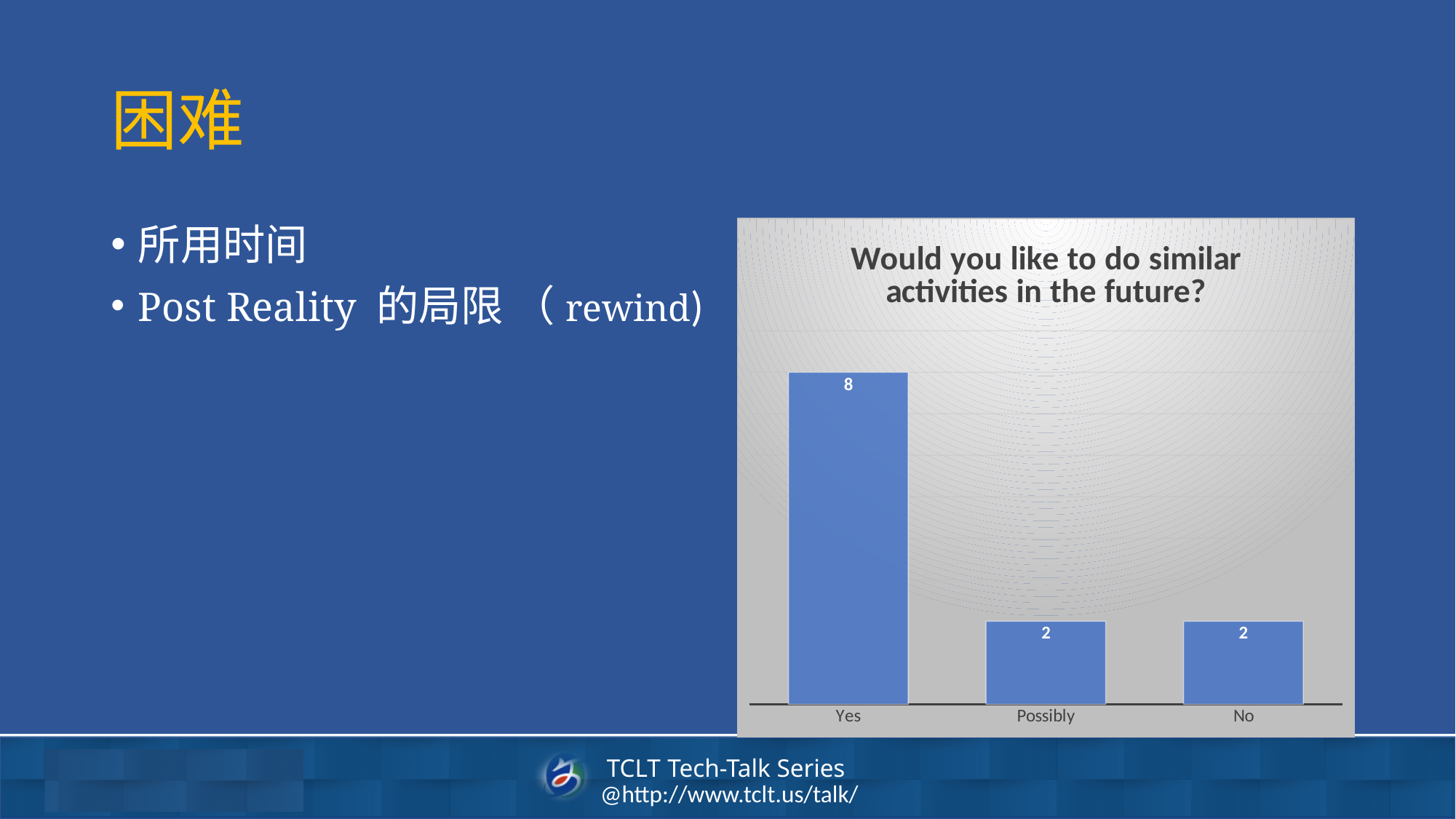
What is the difference between the values for Yes and Possibly? 6 Which category has the highest value? Yes What is the title of the chart? Would you like to do similar activities in the future? What is the difference between the values for Yes and No? 6 What kind of chart is shown on the slide? bar chart Do the values rise or fall from Yes to Possibly? fall What is the value for Yes? 8 What is the value for No? 2 Which is larger, the value for Yes or the value for Possibly? Yes How many categories are shown on the x axis? 3 What is the value for Possibly? 2 What is the total of all three bars? 12